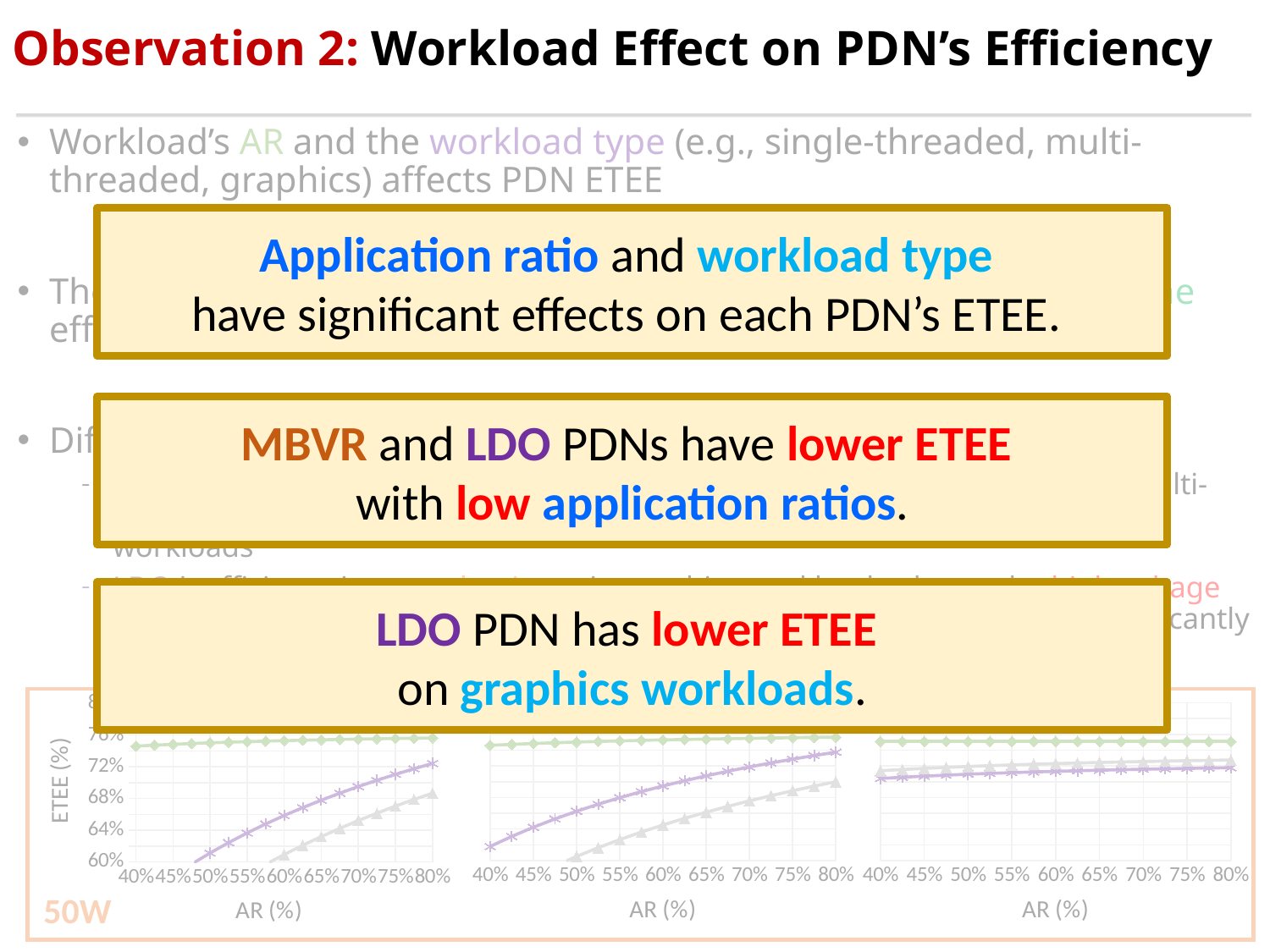
What kind of chart is the left chart at the bottom of the slide? line chart In the middle chart, does the gray triangle series rise or fall as AR increases? rise In the left chart, is the value of the green diamond series at 40% AR greater or less than 72%? greater In the left chart, does the purple star series rise or fall as AR increases? rise What is the y-axis label of the left chart? ETEE (%) In the left chart, is the value of the purple star series at 50% AR greater or less than 64%? less What is the x-axis label of the left chart? AR (%) How many AR tick labels are shown on the x axis of the middle chart? 9 In the left chart at 80% AR, which series has the higher value: the green diamond series or the gray triangle series? green diamond series In the right chart, is the value of the purple star series at 40% AR greater or less than 68%? greater How many charts are shown at the bottom of the slide? 3